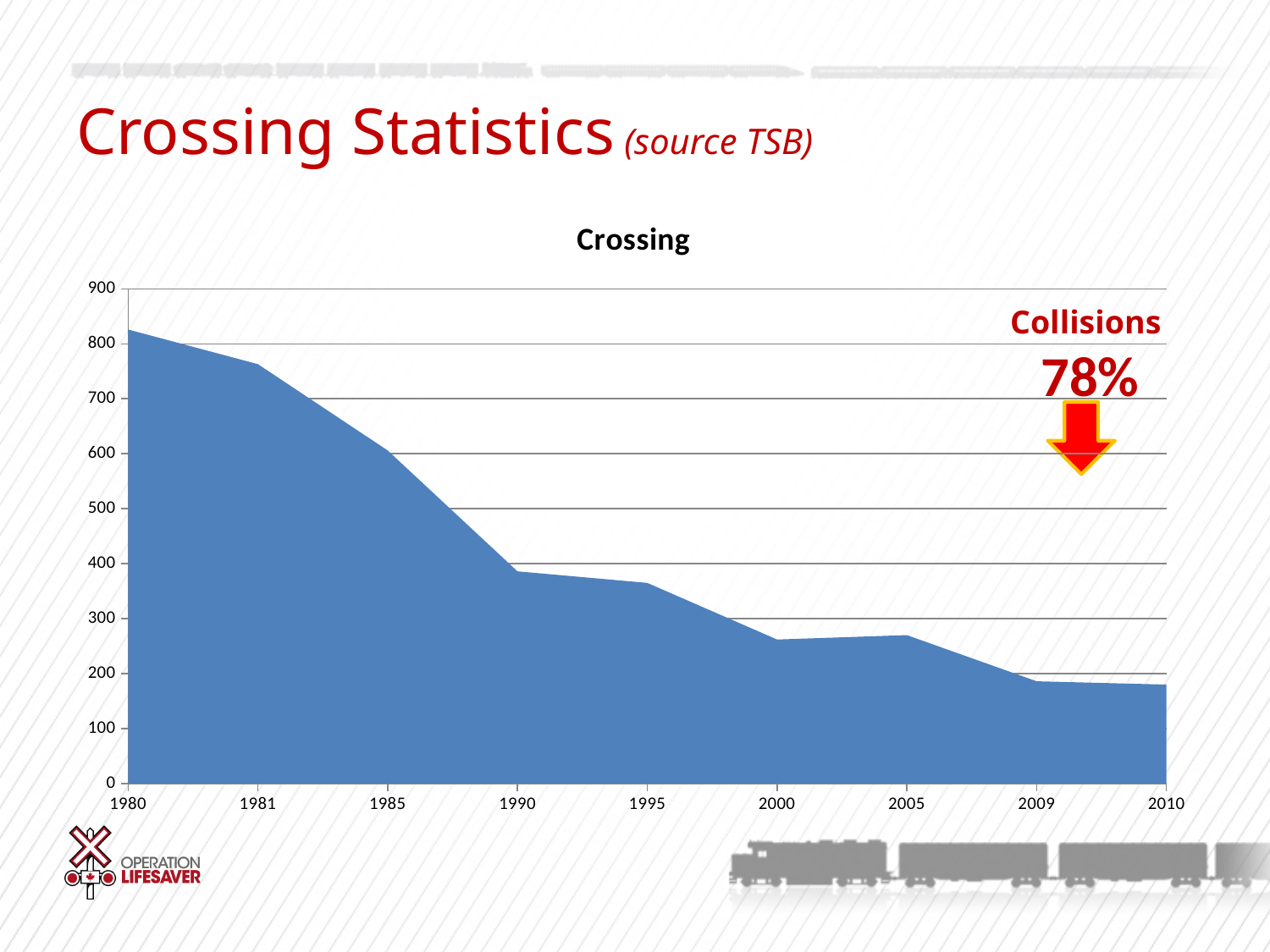
What is the title of the chart? Crossing How many years are labelled on the x axis of the chart? 9 What kind of chart is shown on the slide? area chart What percentage decrease in collisions is annotated on the chart? 78% Is the value for 2000 greater or less than 300? less Is the value for 1985 greater or less than 500? greater Is the value for 1980 greater or less than 800? greater Which is larger, the value for 1981 or the value for 1995? 1981 Do the values in the chart rise or fall from 1980 to 2010? fall Which year has the highest value in the chart? 1980